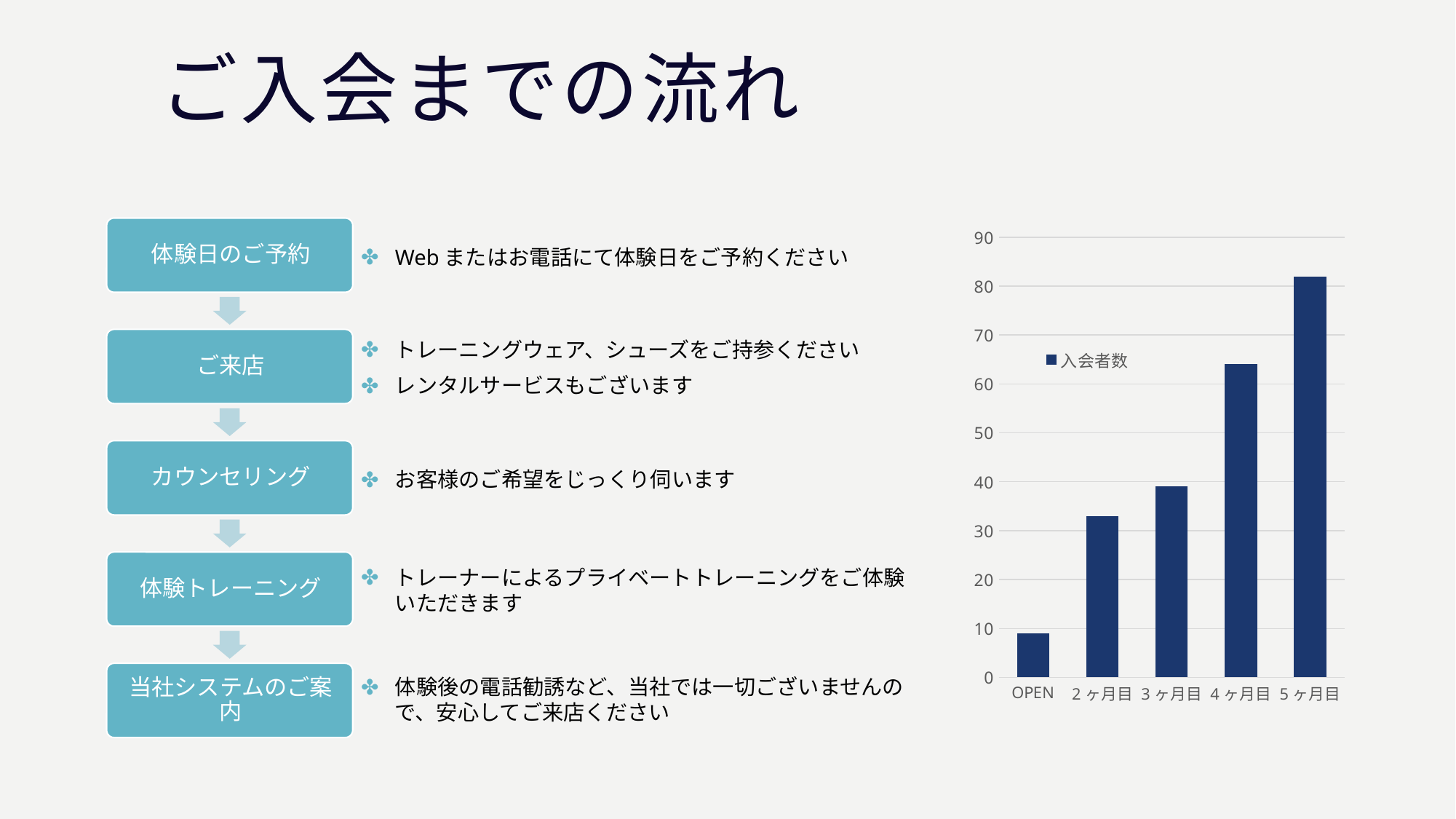
How many series does the chart legend list? 1 Is the value for 3ヶ月目 greater or less than 30? greater How many categories are shown on the x axis of the chart? 5 Do the values rise or fall from OPEN to 5ヶ月目? rise What is the name of the series shown in the chart legend? 入会者数 Is the value for 2ヶ月目 greater or less than 30? greater Is the value for 5ヶ月目 greater or less than 90? less Which is larger, the value for 4ヶ月目 or the value for 2ヶ月目? 4ヶ月目 Which category has the lowest value in the chart? OPEN What kind of chart is shown on the slide? bar chart Which category has the highest value in the chart? 5ヶ月目